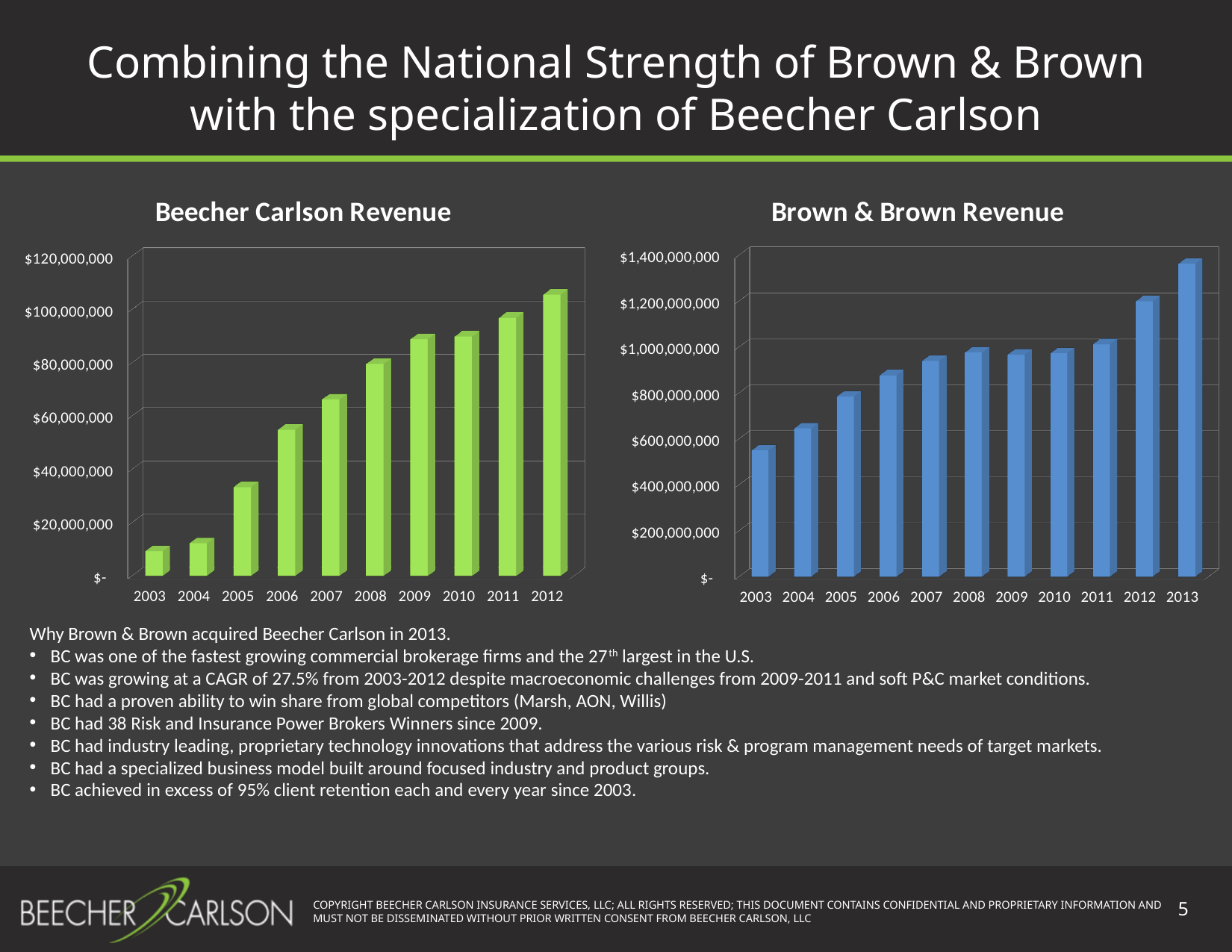
In the Brown & Brown Revenue chart, is the value for 2004 greater or less than $800,000,000? less How many years are shown on the Beecher Carlson Revenue chart? 10 In the Brown & Brown Revenue chart, which year has the lowest revenue? 2003 In the Beecher Carlson Revenue chart, which year has the highest revenue? 2012 How many years are shown on the Brown & Brown Revenue chart? 11 In the Beecher Carlson Revenue chart, is the value for 2012 greater or less than $100,000,000? greater In the Brown & Brown Revenue chart, is the value for 2013 greater or less than $1,200,000,000? greater In the Brown & Brown Revenue chart, which year has the highest revenue? 2013 In the Beecher Carlson Revenue chart, which year has the lowest revenue? 2003 What kind of chart is the Beecher Carlson Revenue chart? Bar chart In the Beecher Carlson Revenue chart, do the values generally rise or fall from 2003 to 2012? Rise